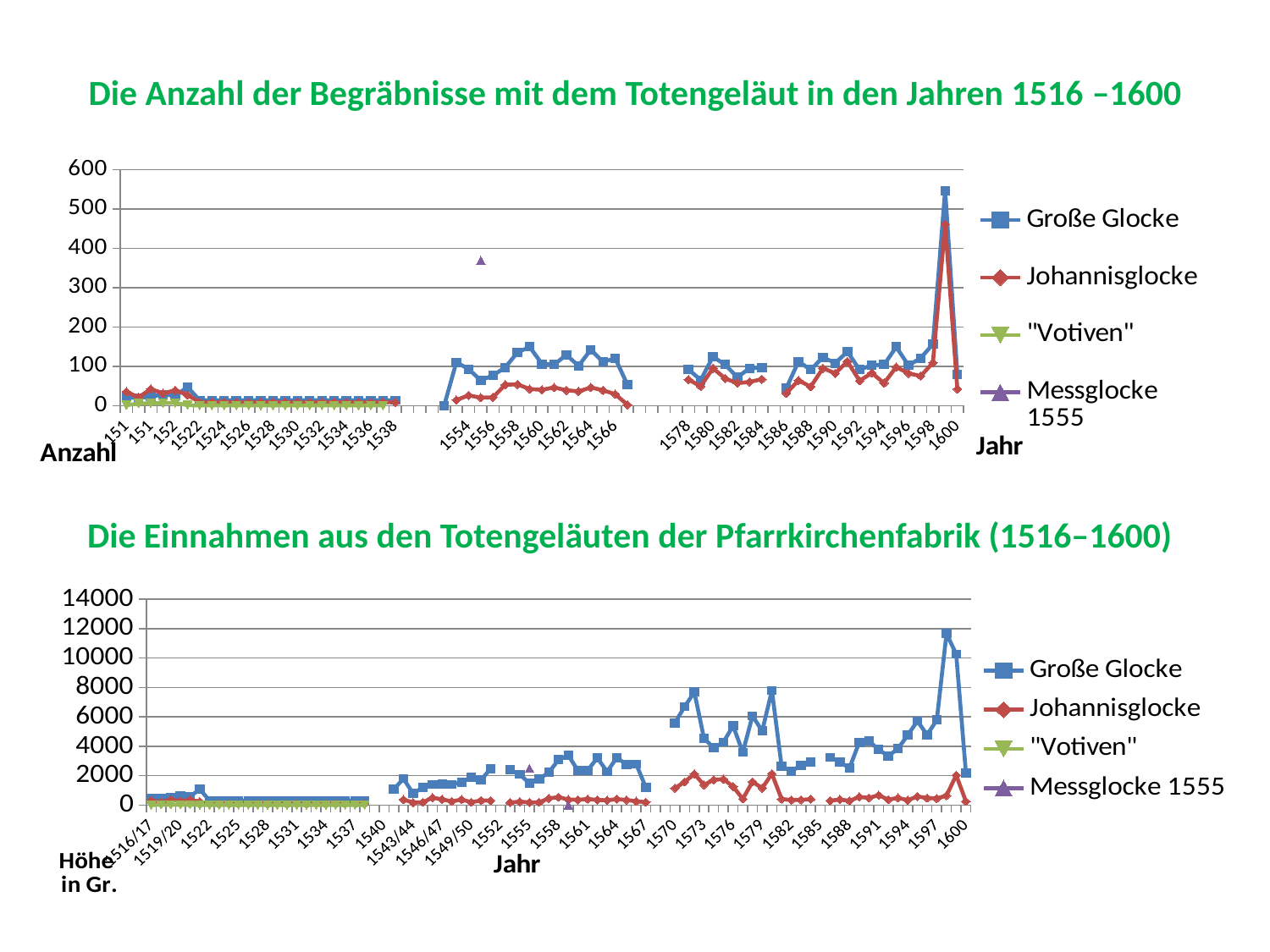
In the top chart, is the Große Glocke value for 1600 greater or less than 200? less What is the label of the vertical axis of the bottom chart? Höhe in Gr. What is the title of the bottom chart? Die Einnahmen aus den Totengeläuten der Pfarrkirchenfabrik (1516–1600) In the top chart, at the peak near 1599, which series has the larger value: Große Glocke or Johannisglocke? Große Glocke In the top chart, is the single plotted value for Messglocke 1555 greater or less than 300? greater How many series does the legend of the top chart list? 4 In the top chart, which series reaches the highest value overall? Große Glocke In the bottom chart, which series reaches the highest value overall? Große Glocke In the top chart, is the highest value of the Große Glocke series greater or less than 500? greater How many series does the legend of the bottom chart, 'Die Einnahmen aus den Totengeläuten der Pfarrkirchenfabrik (1516–1600)', list? 4 What type of chart is the top chart, 'Die Anzahl der Begräbnisse mit dem Totengeläut in den Jahren 1516 –1600'? Line chart